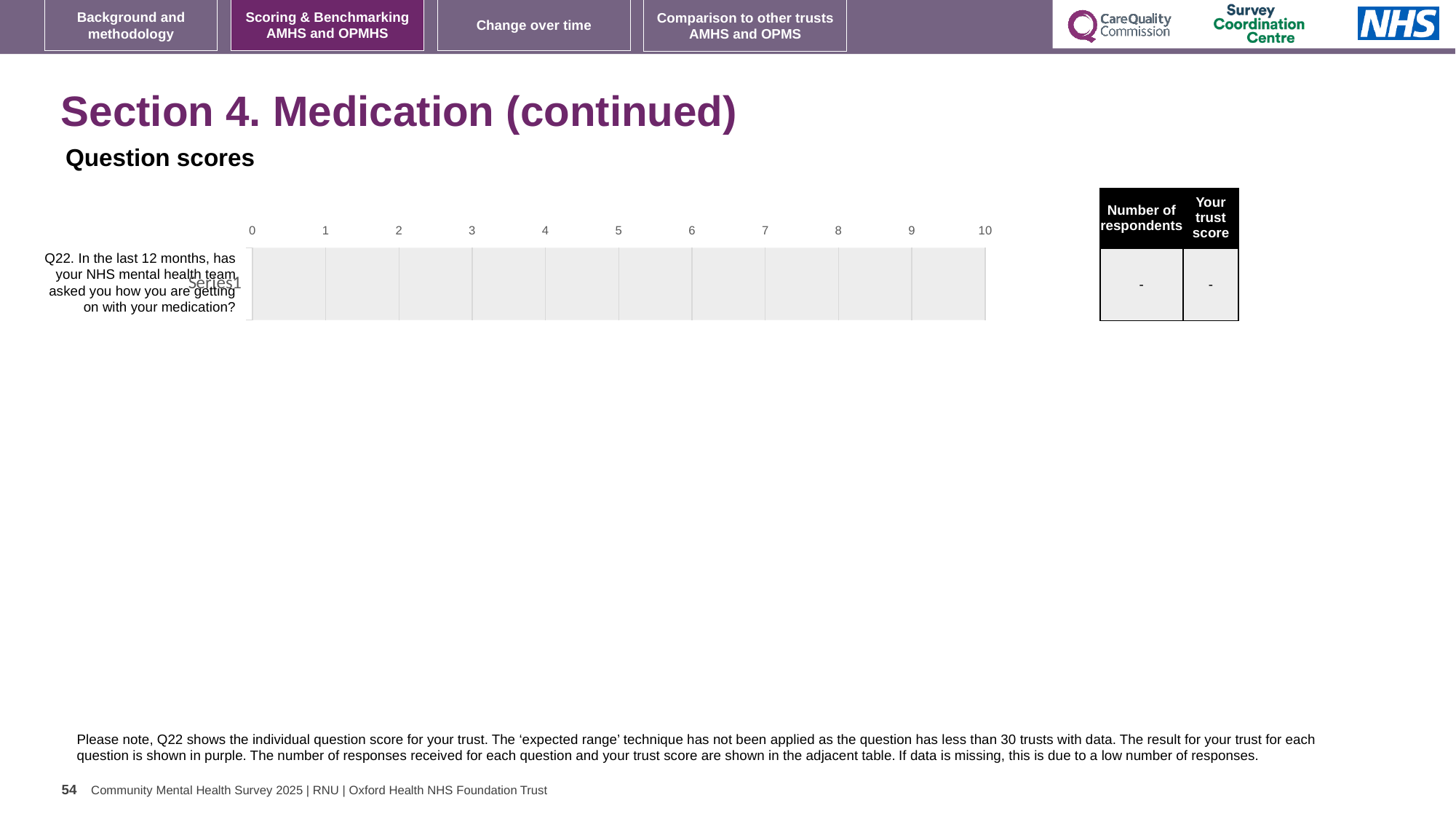
What kind of chart is shown under 'Question scores'? bar chart What is the lowest value shown on the chart's horizontal axis? 0 What is the highest value shown on the chart's horizontal axis? 10 How many questions (categories) are listed on the chart's vertical axis? 1 What is shown in the 'Your trust score' column of the table next to the chart for Q22? - Is a bar value plotted for Q22 on the chart? No What is shown in the 'Number of respondents' column of the table next to the chart for Q22? - Which question is listed as the category on the chart? Q22. In the last 12 months, has your NHS mental health team asked you how you are getting on with your medication?